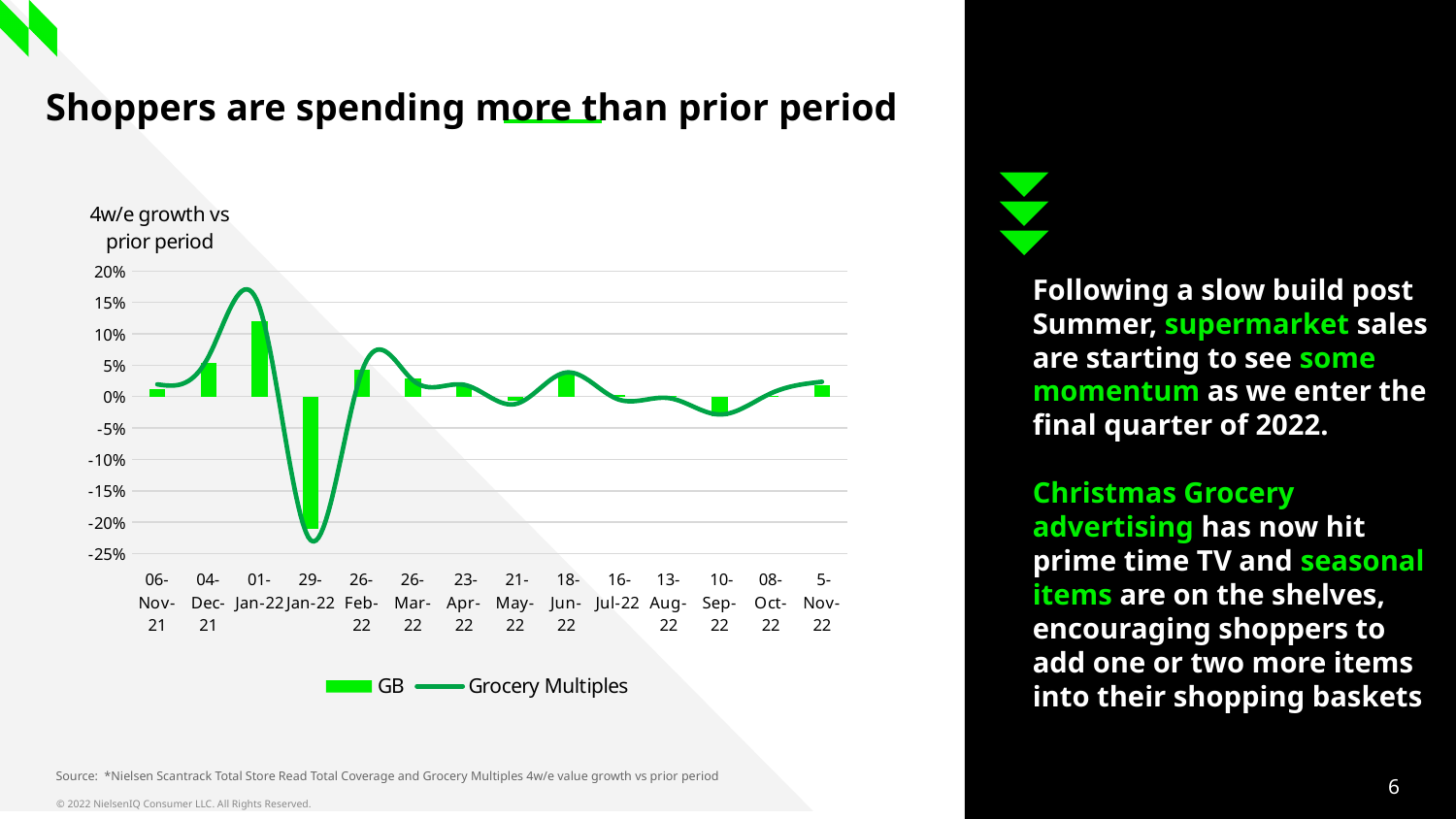
What is the title shown on the chart's vertical axis? 4w/e growth vs prior period In which period is the GB bar the highest? 01-Jan-22 Which is larger, the GB value for 10-Sep-22 or the GB value for 5-Nov-22? 5-Nov-22 Which is larger, the GB value for 01-Jan-22 or the GB value for 26-Feb-22? 01-Jan-22 Is the GB value for 01-Jan-22 greater or less than 5%? greater In which period is the GB bar the lowest? 29-Jan-22 What kind of chart is shown on the slide? A combined bar and line chart How many series does the chart legend list? 2 What are the two series named in the chart legend? GB and Grocery Multiples Is the Grocery Multiples value for 29-Jan-22 greater or less than -20%? less How many dated periods are shown along the x axis of the chart? 14 Is the GB value for 29-Jan-22 greater or less than -10%? less